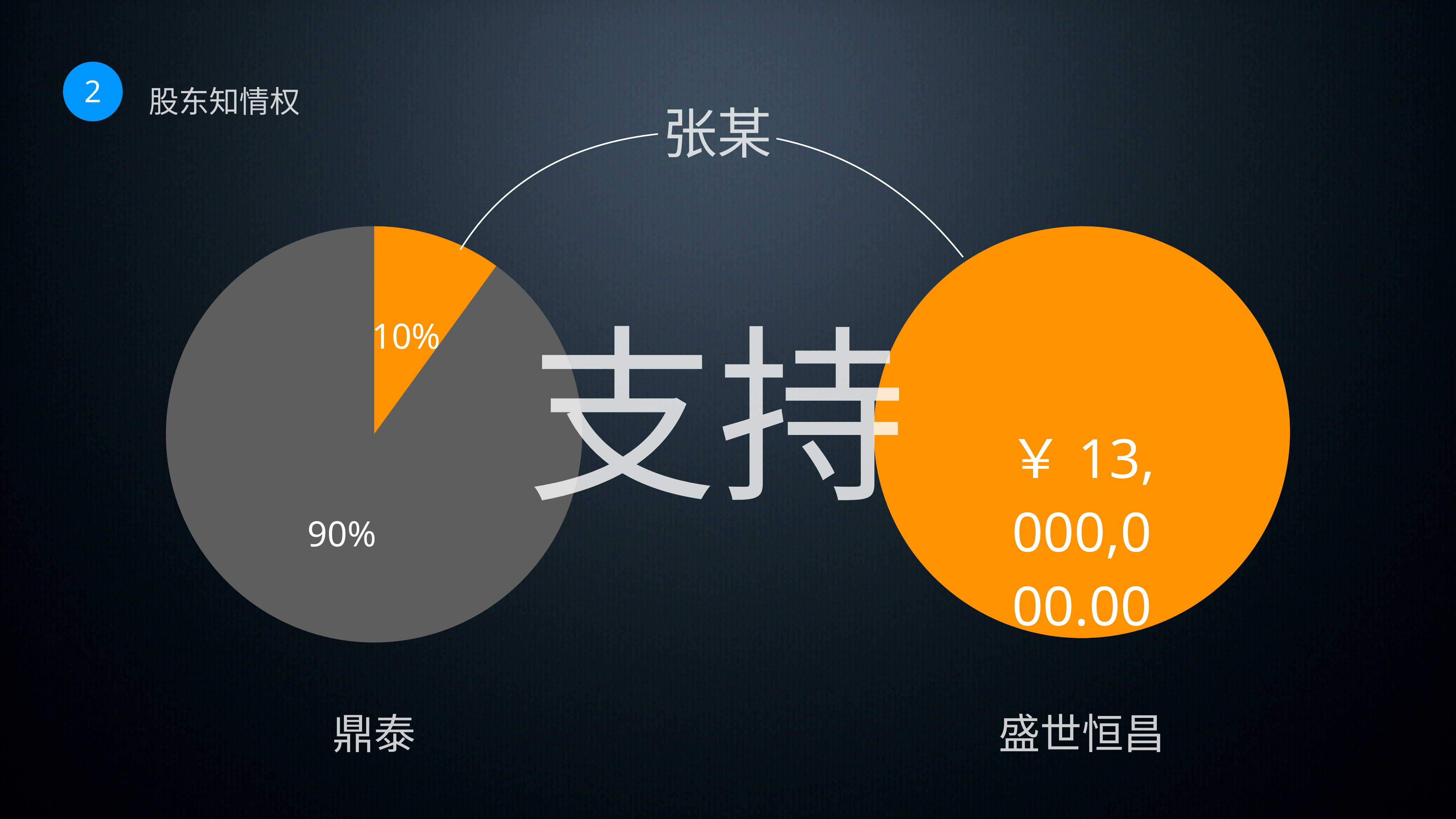
How many slices does the pie chart labelled 鼎泰 have? 2 What label appears below the pie chart on the slide? 鼎泰 In the pie chart labelled 鼎泰, what is the difference between the grey slice and the orange slice? 80% In the pie chart labelled 鼎泰, is the value of the orange slice greater or less than 50%? less In the pie chart labelled 鼎泰, what share of the pie does the orange slice represent? 10% In the pie chart labelled 鼎泰, what share of the pie does the grey slice represent? 90% What colour is the 10% slice in the pie chart labelled 鼎泰? orange What kind of chart is shown under the label 鼎泰? pie chart In the pie chart labelled 鼎泰, what is the value of the smallest slice? 10% In the pie chart labelled 鼎泰, which slice is larger, the grey one or the orange one? the grey one In the pie chart labelled 鼎泰, what is the value of the largest slice? 90%